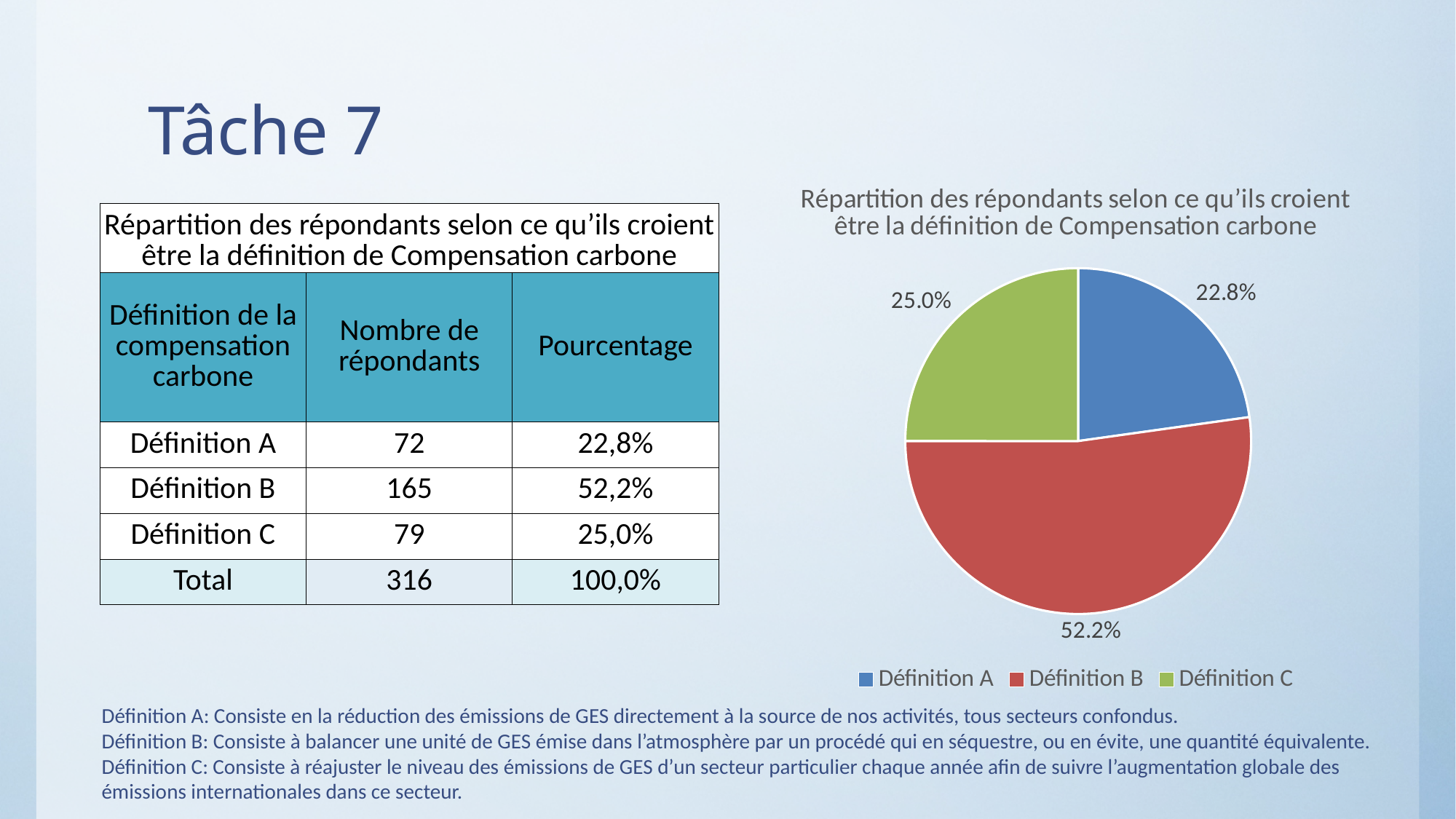
What share of the pie does Définition C represent? 25.0% What share of the pie does Définition A represent? 22.8% What is the title of the pie chart? Répartition des répondants selon ce qu'ils croient être la définition de Compensation carbone What is the difference in percentage points between the Définition B slice and the Définition C slice? 27.2 Which definition has the largest slice of the pie? Définition B Which definition has the smallest slice of the pie? Définition A What share of the pie does Définition B represent? 52.2% How many entries does the legend list? 3 What kind of chart is shown on the slide? pie chart What colour is the slice for Définition B? red How many slices does the pie chart have? 3 Which slice is larger, Définition C or Définition A? Définition C